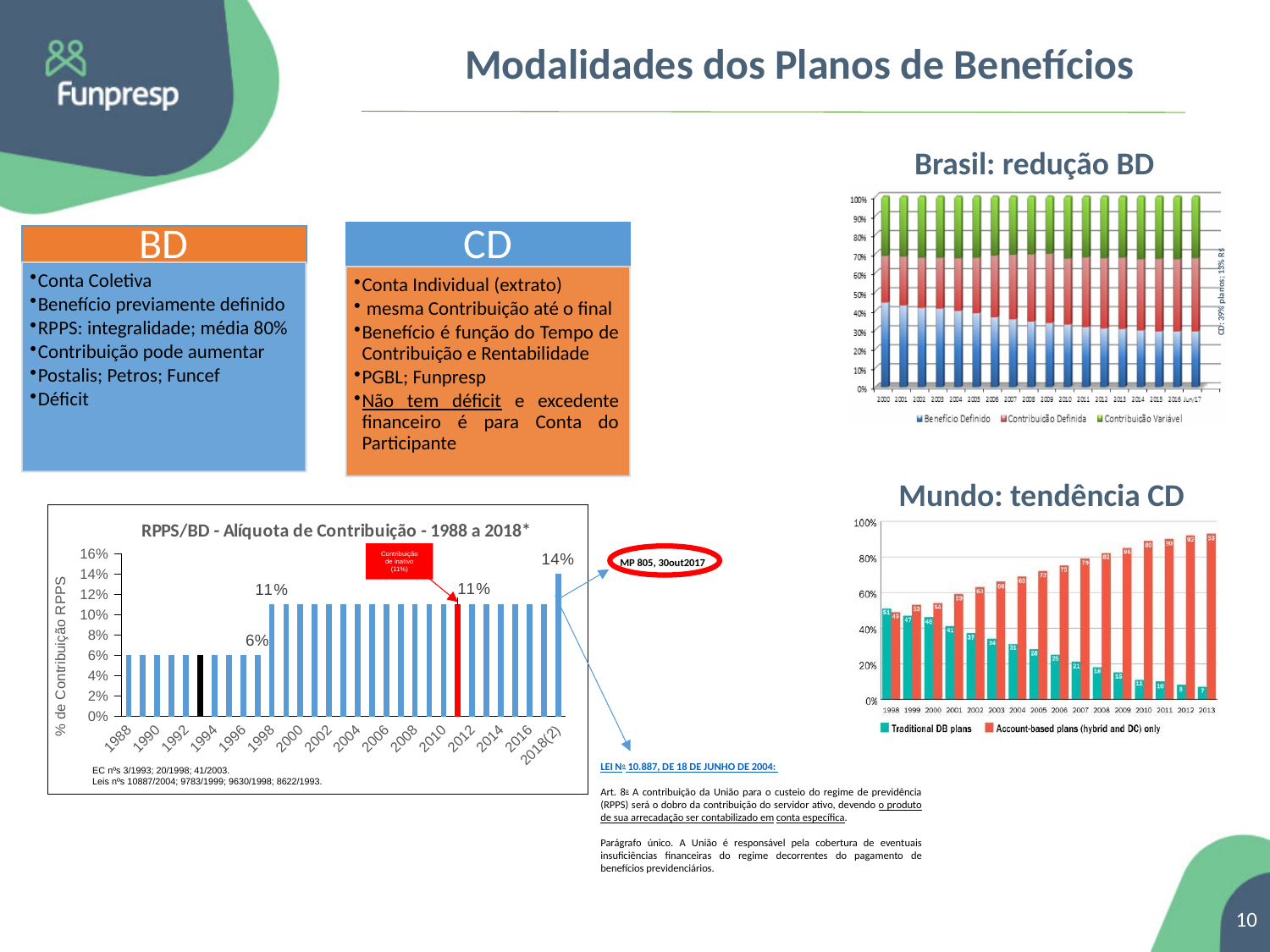
In the 'Mundo: tendência CD' chart, which series has the larger value in 2013? Account-based plans (hybrid and DC) only In the 'RPPS/BD - Alíquota de Contribuição - 1988 a 2018*' chart, do the values rise or fall from 1988 to 2018(2)? Rise In the 'Mundo: tendência CD' chart, do the values for Traditional DB plans rise or fall from 1998 to 2013? Fall What kind of chart is the 'RPPS/BD - Alíquota de Contribuição - 1988 a 2018*' chart? Bar chart What kind of chart is the 'Brasil: redução BD' chart? Stacked bar chart In the 'RPPS/BD - Alíquota de Contribuição - 1988 a 2018*' chart, which year has the highest contribution rate? 2018(2) In the 'Mundo: tendência CD' chart, how many series does the legend list? 2 In the 'RPPS/BD - Alíquota de Contribuição - 1988 a 2018*' chart, what is the difference between the value for 2018(2) and the value for 2012? 3 percentage points In the 'RPPS/BD - Alíquota de Contribuição - 1988 a 2018*' chart, what is the value for 2018(2)? 14% In the 'Brasil: redução BD' chart, how many series does the legend list? 3 In the 'Mundo: tendência CD' chart, what are the two series named in the legend? Traditional DB plans; Account-based plans (hybrid and DC) only In the 'RPPS/BD - Alíquota de Contribuição - 1988 a 2018*' chart, what is the value for 1998? 11%